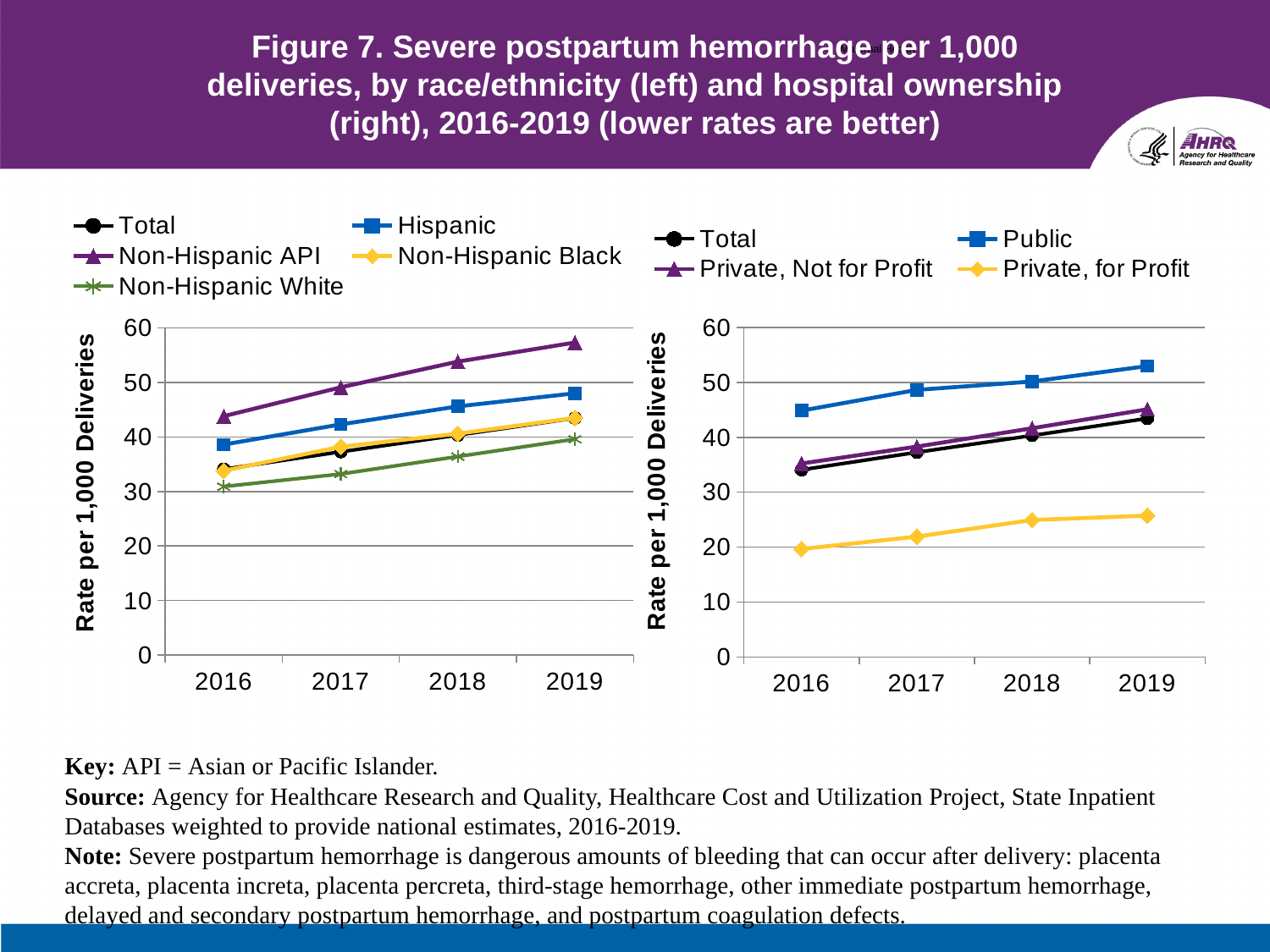
How many series does the legend of the left chart (by race/ethnicity) list? 5 In the right chart (by hospital ownership), which series has the highest rate in 2019? Public In the right chart (by hospital ownership), which is larger in 2016: Public or Private, for Profit? Public How many series does the legend of the right chart (by hospital ownership) list? 4 In the right chart (by hospital ownership), is the value for Public in 2016 greater or less than 50? less What kind of chart is the left chart (by race/ethnicity)? Line chart In the left chart (by race/ethnicity), does the Hispanic rate rise or fall from 2016 to 2019? Rises In the left chart (by race/ethnicity), which series has the lowest rate in 2016? Non-Hispanic White In the right chart (by hospital ownership), which series has the lowest rate across all years? Private, for Profit In the left chart (by race/ethnicity), which series has the highest rate in 2019? Non-Hispanic API In the left chart (by race/ethnicity), is the value for Non-Hispanic API in 2019 greater or less than 50? greater How many years are plotted along the x axis of the right chart (by hospital ownership)? 4